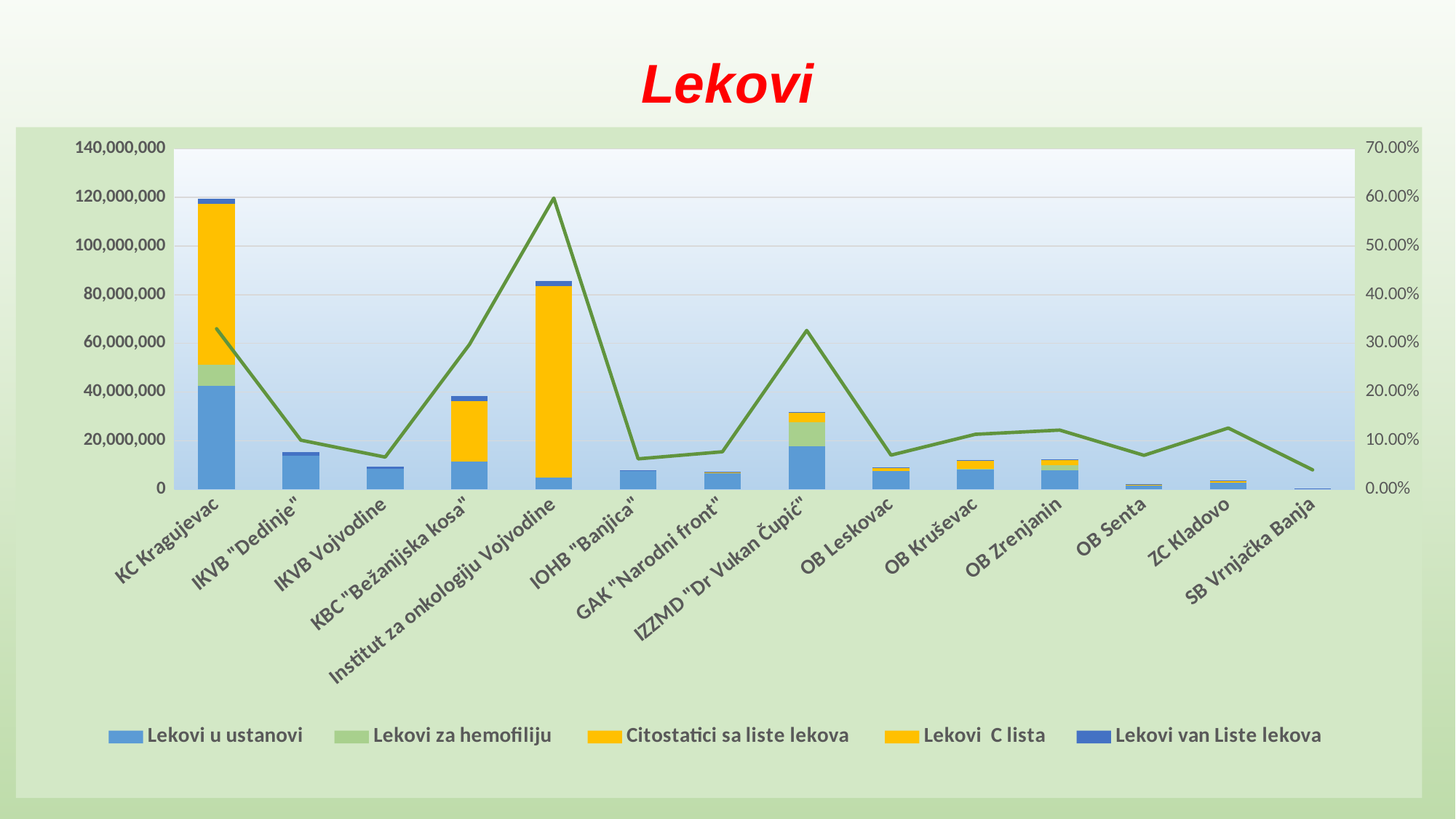
Is the total bar for IKVB "Dedinje" greater or less than 20,000,000? less How many categories (institutions) are shown on the x axis? 14 At which institution does the line reach its highest point? Institut za onkologiju Vojvodine Which has the larger total bar, KC Kragujevac or Institut za onkologiju Vojvodine? KC Kragujevac Which institution has the tallest stacked bar? KC Kragujevac Which colour represents the series "Lekovi u ustanovi" in the legend? Blue What is the title of the chart? Lekovi How many series does the legend list? 5 Is the line value for Institut za onkologiju Vojvodine greater or less than 50.00%? greater Which institution has the smallest stacked bar? SB Vrnjačka Banja What kind of chart is shown on the slide? Stacked bar chart with a line Is the total bar for KC Kragujevac greater or less than 100,000,000? greater